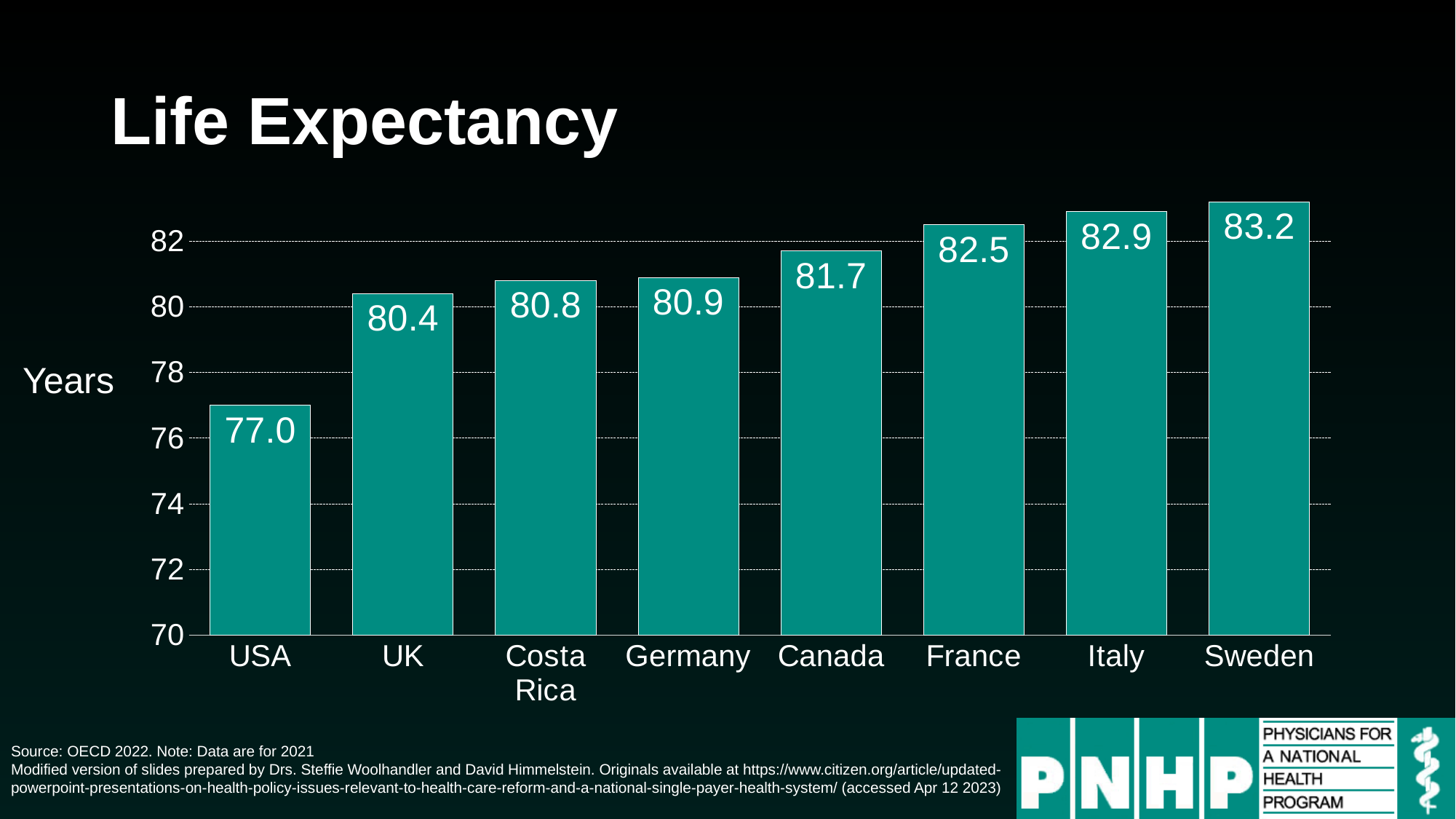
What is the difference in life expectancy between Italy and the UK? 2.5 Which has a higher life expectancy, Germany or the UK? Germany What is the life expectancy shown for the USA? 77.0 Which country has the highest life expectancy on the chart? Sweden What is the difference in life expectancy between Sweden and the USA? 6.2 What is the life expectancy shown for France? 82.5 Is the value for Costa Rica greater or less than 80? greater How many countries are shown on the chart? 8 Which country has the lowest life expectancy on the chart? USA What kind of chart is shown on the slide? bar chart What is the life expectancy shown for Canada? 81.7 What is the title of the chart? Life Expectancy